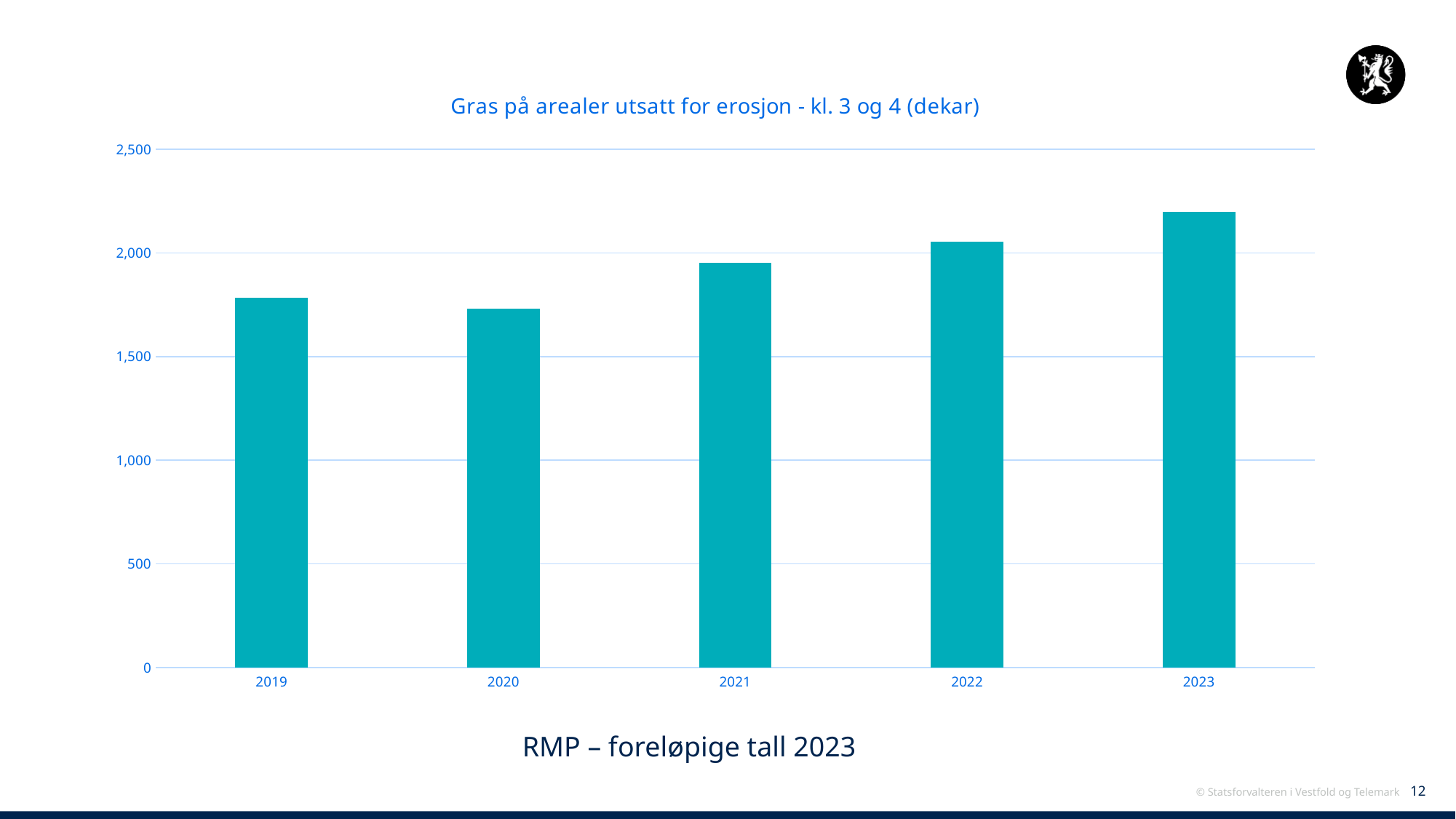
What is the title of the chart? Gras på arealer utsatt for erosjon - kl. 3 og 4 (dekar) What is the highest value shown on the y axis of the chart? 2,500 Which year has the highest value in the chart? 2023 Is the value for 2020 greater or less than 2,000? less Do the values rise or fall from 2020 to 2023? rise Which is larger, the value for 2023 or the value for 2019? 2023 Which year has the lowest value in the chart? 2020 Is the value for 2019 greater or less than 1,500? greater How many years are shown on the x axis of the chart? 5 Is the value for 2023 greater or less than 2,000? greater What kind of chart is shown on the slide? bar chart